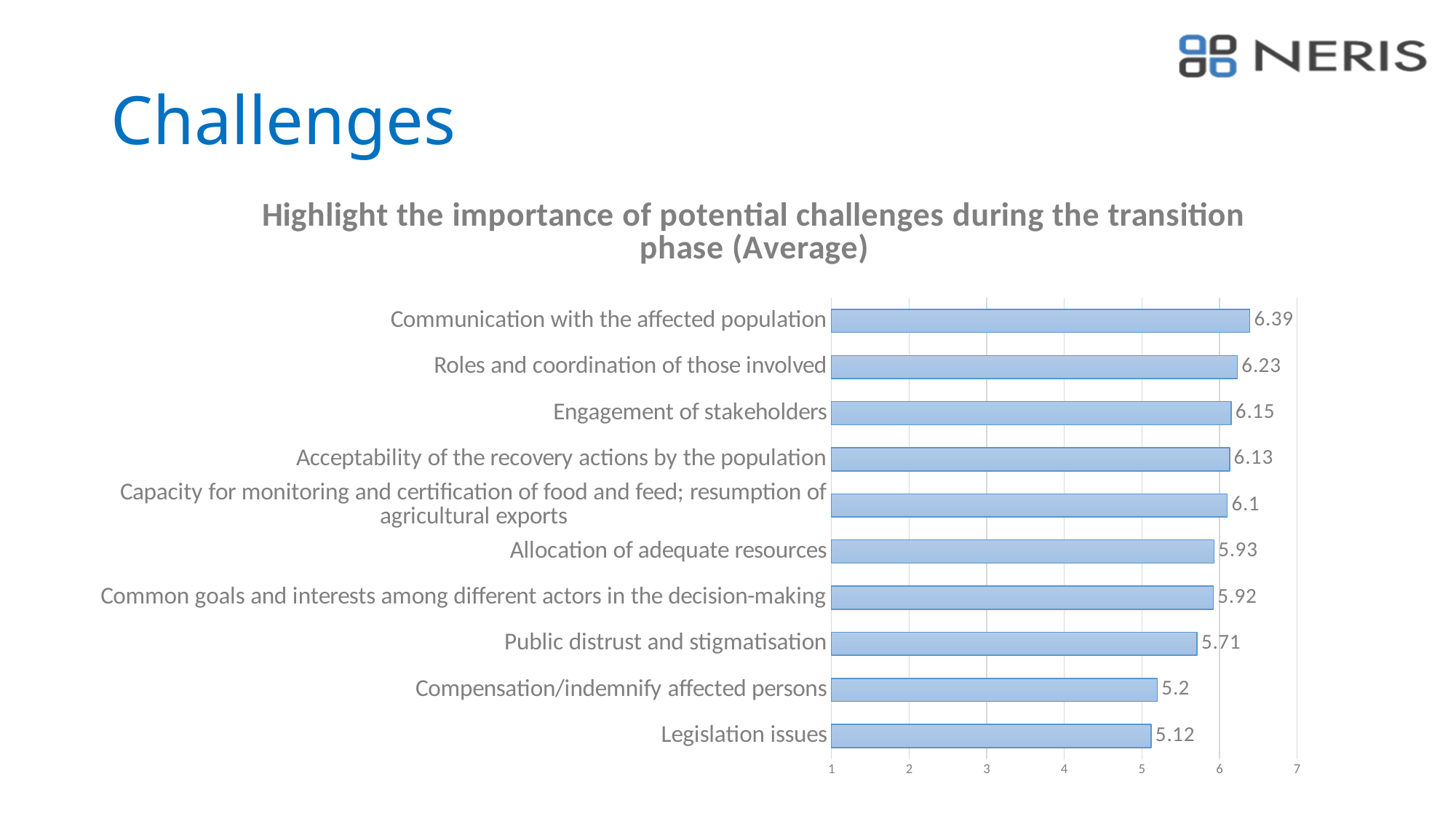
What is the average importance value for 'Communication with the affected population'? 6.39 How many challenges are plotted in the chart? 10 What is the value shown for 'Legislation issues'? 5.12 Which has a higher value: 'Roles and coordination of those involved' or 'Compensation/indemnify affected persons'? Roles and coordination of those involved Which challenge has the highest average importance? Communication with the affected population What is the title of the chart? Highlight the importance of potential challenges during the transition phase (Average) Is the value for 'Allocation of adequate resources' greater or less than 6? less What kind of chart is shown on the slide? Bar chart What is the value shown for 'Public distrust and stigmatisation'? 5.71 What is the value shown for 'Capacity for monitoring and certification of food and feed; resumption of agricultural exports'? 6.1 Which challenge has the lowest average importance? Legislation issues What is the difference between the values for 'Communication with the affected population' and 'Legislation issues'? 1.27